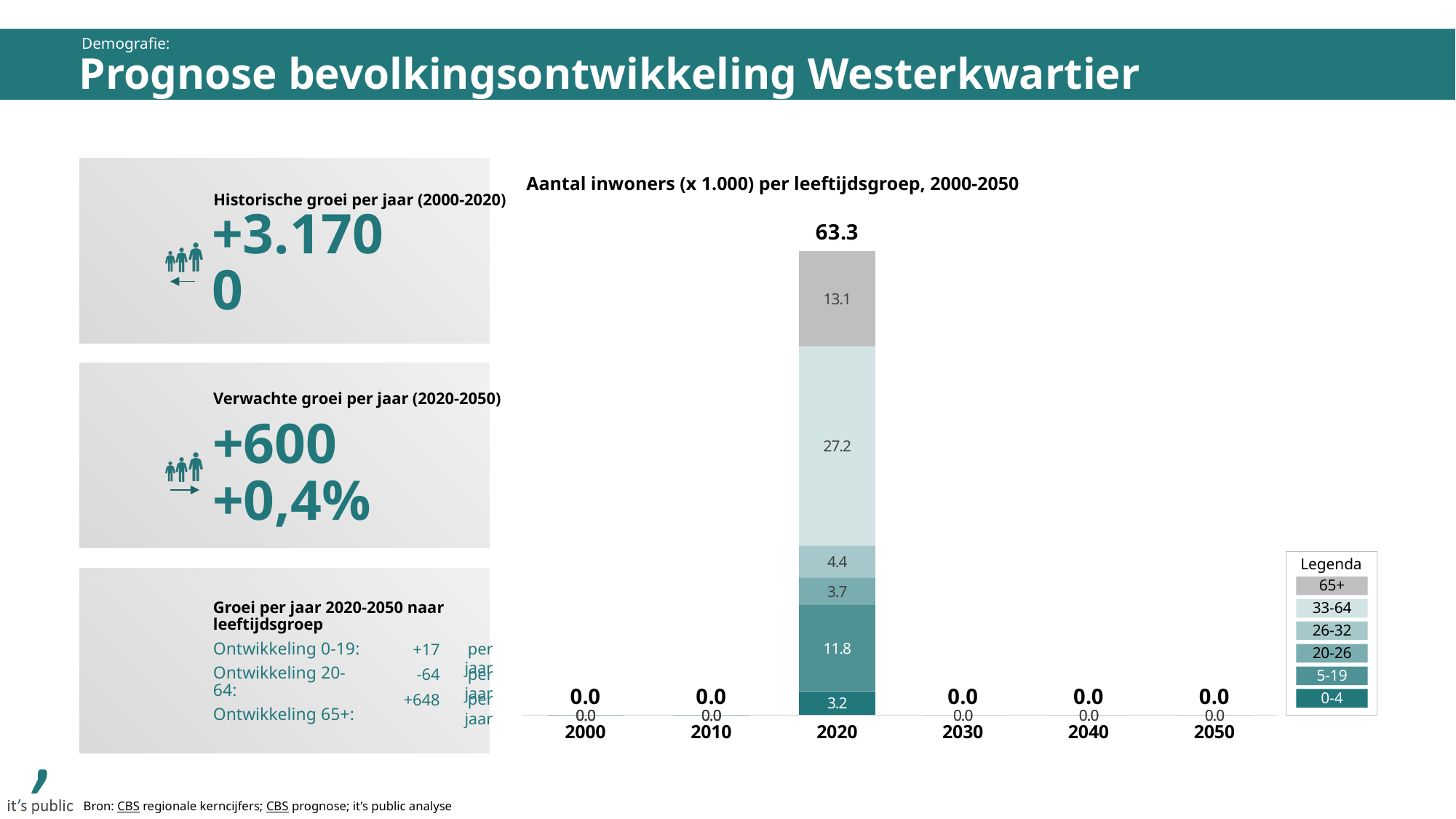
What is the value for the 0-4 age group in 2020? 3.2 What is the difference between the 33-64 and 65+ values in 2020? 14.1 What is the value for the 5-19 age group in 2020? 11.8 How many years are shown on the x axis of the chart? 6 What is the value for the 65+ age group in 2020? 13.1 How many series does the legend list? 6 Which age group has the smallest value in the 2020 bar? 0-4 What is the title of the chart? Aantal inwoners (x 1.000) per leeftijdsgroep, 2000-2050 What kind of chart is shown on the slide? Stacked bar chart What is the value for the 33-64 age group in 2020? 27.2 Which age group has the largest value in the 2020 bar? 33-64 What is the total value shown above the 2020 bar? 63.3